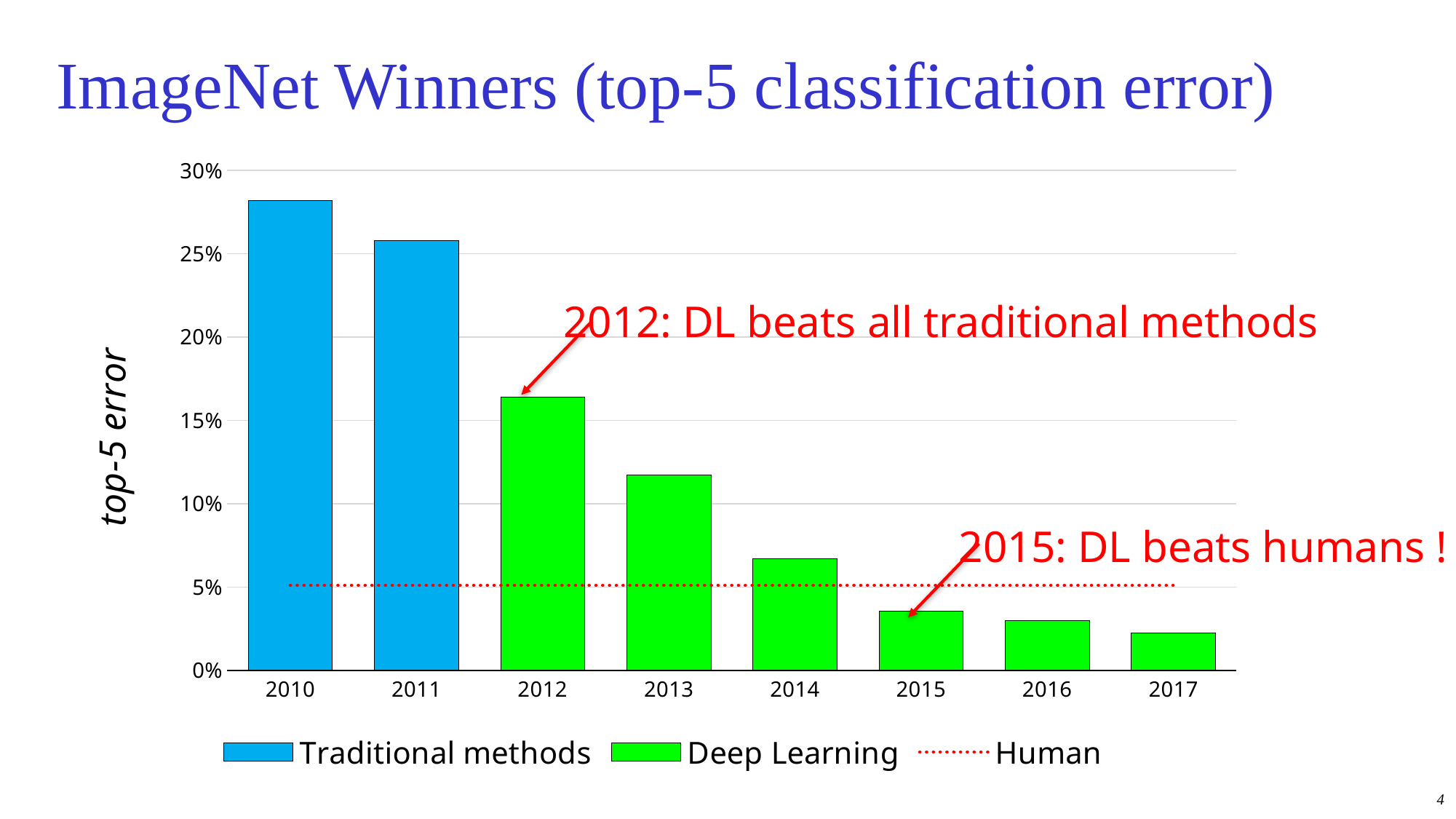
Which year has the lowest top-5 error? 2017 How many years are shown on the x axis? 8 Which legend entry is shown in green? Deep Learning Is the top-5 error for 2015 greater or less than 5%? less Is the top-5 error for 2010 greater or less than 25%? greater Which year has the highest top-5 error? 2010 What kind of chart is shown on the slide? bar chart How many entries does the legend list? 3 Which year has the larger top-5 error, 2012 or 2013? 2012 Is the top-5 error for 2012 greater or less than 15%? greater Do the top-5 error values rise or fall from 2010 to 2017? fall